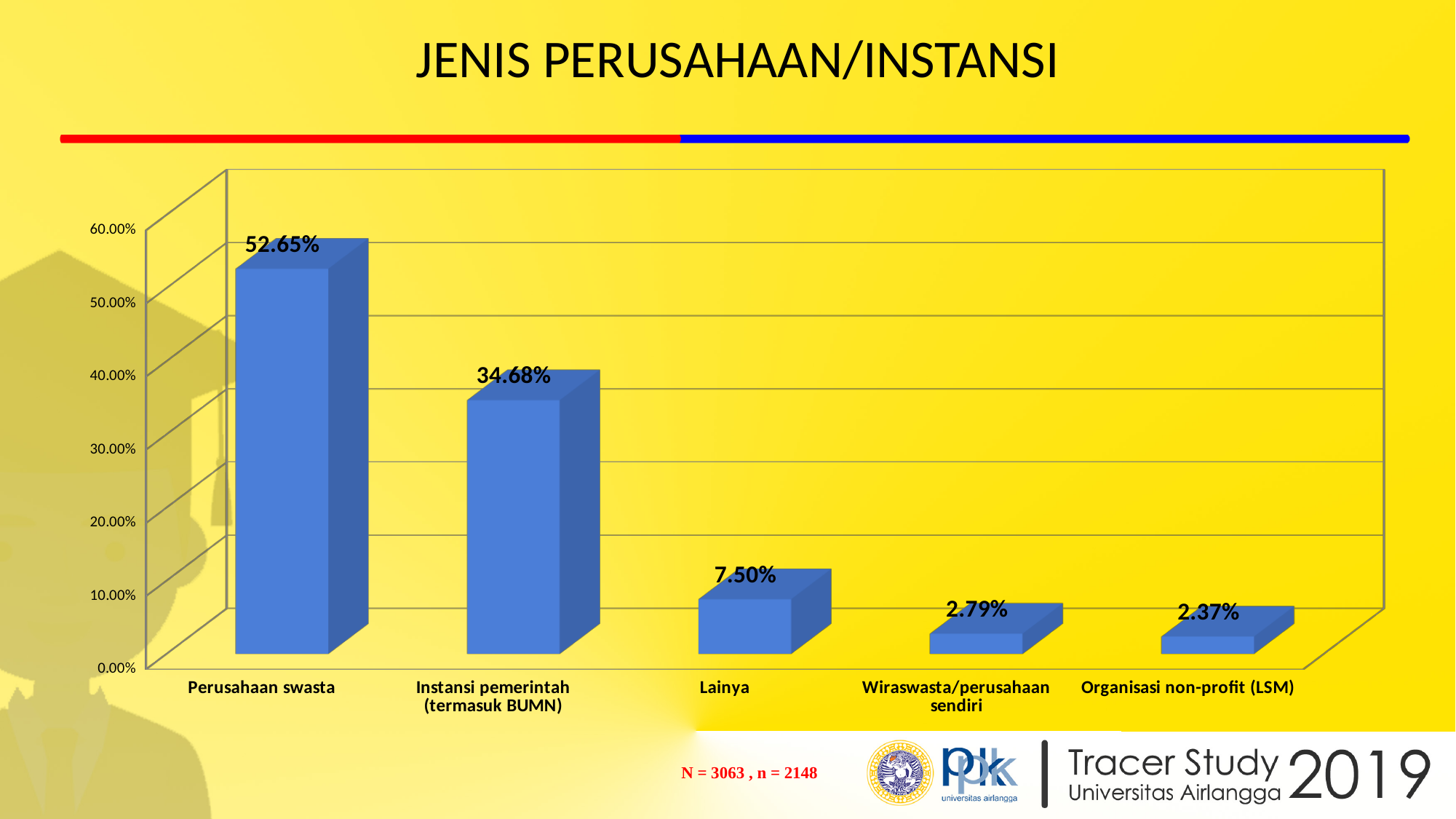
What is the value for Wiraswasta/perusahaan sendiri? 2.79% What is the value for Organisasi non-profit (LSM)? 2.37% What is the difference between the values for Perusahaan swasta and Instansi pemerintah (termasuk BUMN)? 17.97% Which category has the lowest value? Organisasi non-profit (LSM) What is the value for Perusahaan swasta? 52.65% Which is larger, the value for Lainya or the value for Wiraswasta/perusahaan sendiri? Lainya What is the value for Lainya? 7.50% What kind of chart is shown on the slide? Bar chart Which category has the highest value? Perusahaan swasta What is the value for Instansi pemerintah (termasuk BUMN)? 34.68% How many categories are shown in the chart? 5 What is the title of the slide? JENIS PERUSAHAAN/INSTANSI